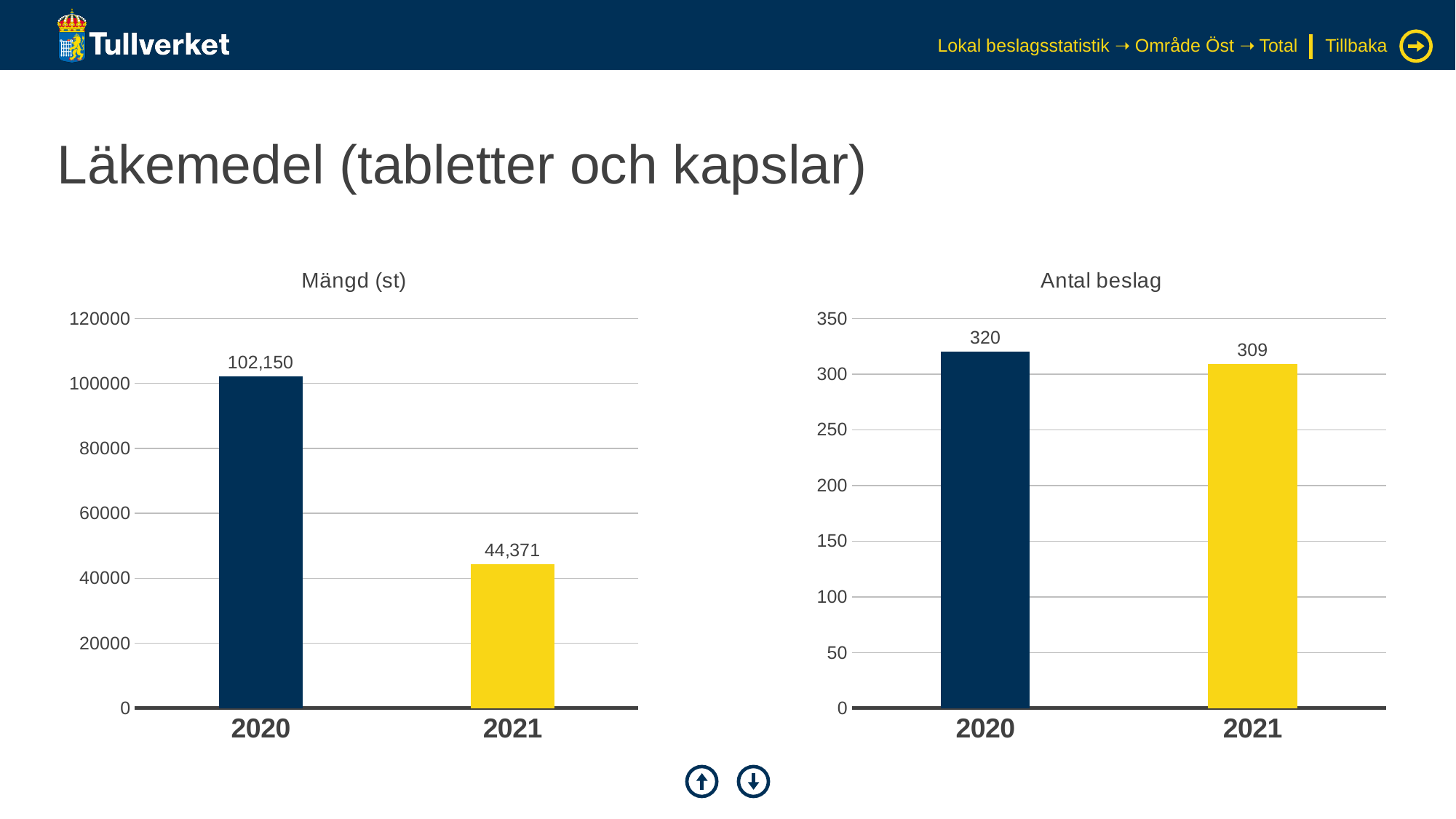
What kind of chart is the 'Mängd (st)' chart? bar chart In the 'Mängd (st)' chart, what is the difference between the 2020 and 2021 values? 57,779 In the 'Mängd (st)' chart, what is the value for 2020? 102,150 In the 'Mängd (st)' chart, do the values rise or fall from 2020 to 2021? fall In the 'Mängd (st)' chart, is the value for 2021 greater or less than 60000? less How many years are shown in the 'Antal beslag' chart? 2 In the 'Mängd (st)' chart, what is the value for 2021? 44,371 In the 'Antal beslag' chart, what is the value for 2020? 320 In the 'Mängd (st)' chart, which year has the highest value? 2020 In the 'Antal beslag' chart, which year has the lowest value? 2021 In the 'Antal beslag' chart, what is the value for 2021? 309 In the 'Antal beslag' chart, what is the difference between the 2020 and 2021 values? 11